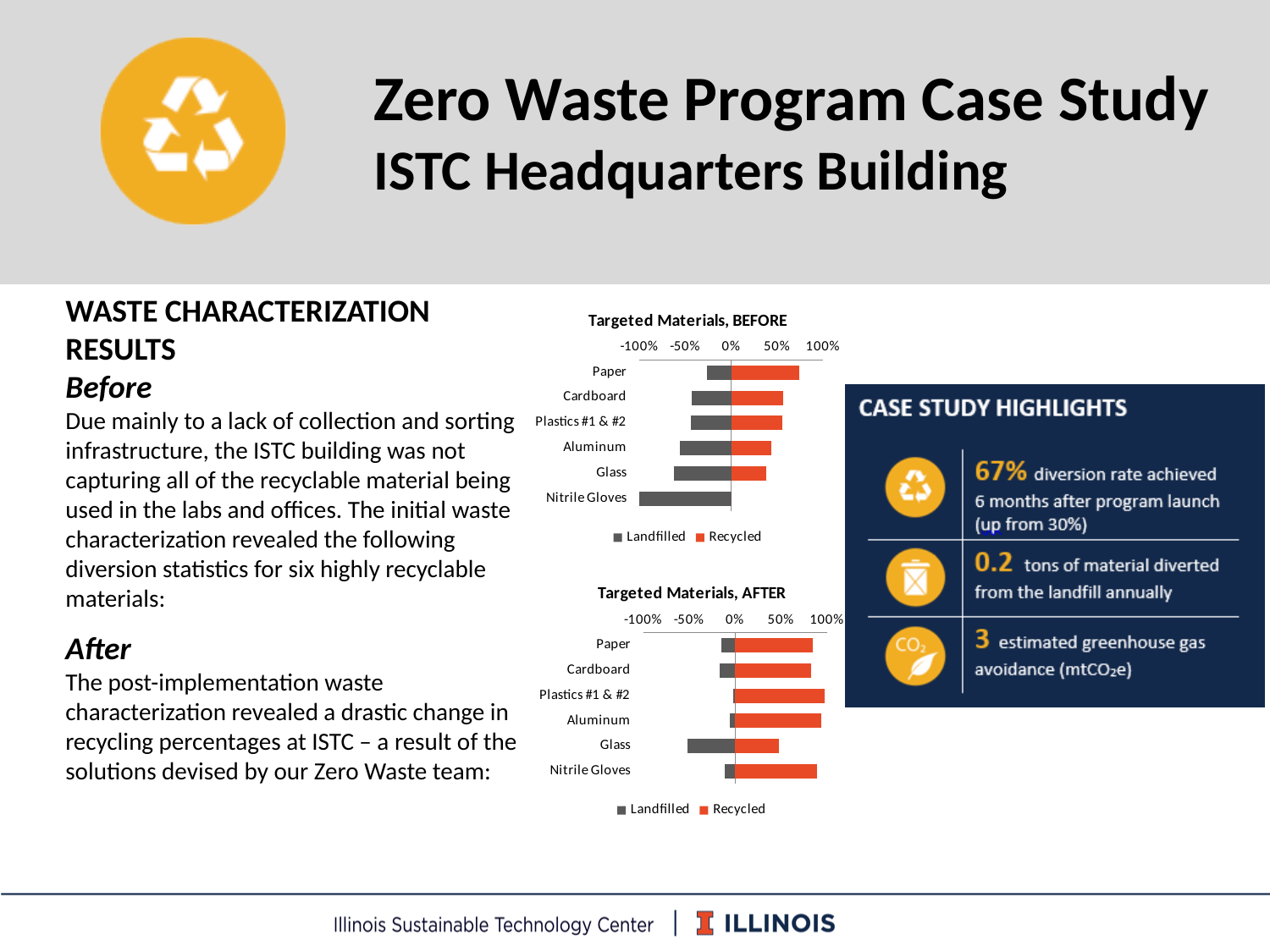
In the "Targeted Materials, AFTER" chart, which material has the largest Landfilled bar? Glass In the "Targeted Materials, BEFORE" chart, which material has the highest Recycled value? Paper In the "Targeted Materials, BEFORE" chart, is the Recycled value for Glass greater or less than 50%? less In the "Targeted Materials, AFTER" chart, is the Recycled value for Nitrile Gloves greater or less than 50%? greater What kind of chart is the "Targeted Materials, BEFORE" chart? Bar chart In the "Targeted Materials, BEFORE" chart, is the Recycled value for Paper greater or less than 50%? greater In the "Targeted Materials, AFTER" chart, which has the larger Recycled value, Paper or Glass? Paper How many series does the legend of the "Targeted Materials, BEFORE" chart list? 2 In the "Targeted Materials, BEFORE" chart, which material has the largest Landfilled bar? Nitrile Gloves In the "Targeted Materials, AFTER" chart, which colour represents the Recycled series? Orange How many materials are listed on the "Targeted Materials, AFTER" chart? 6